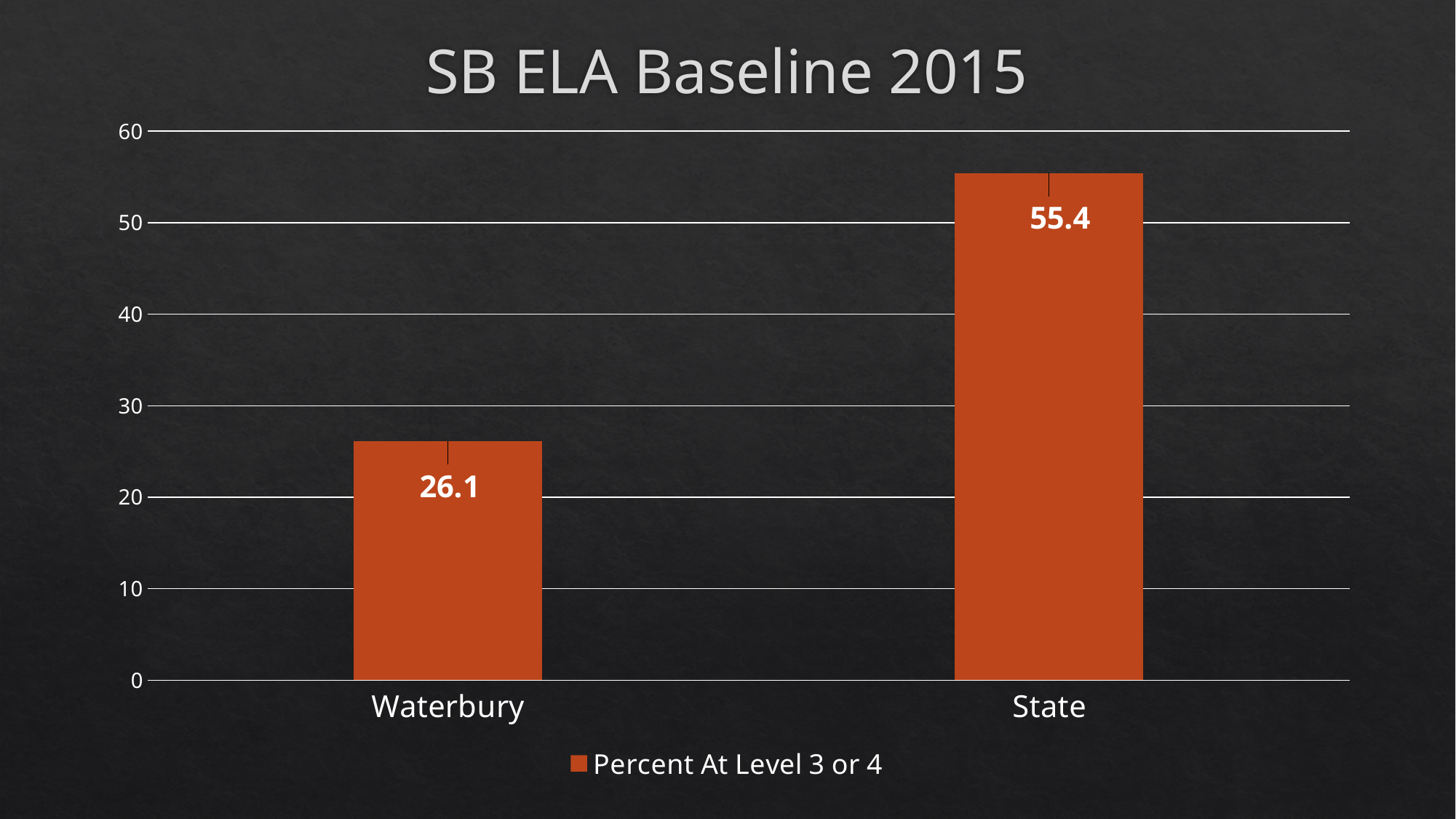
How many categories are shown on the x axis? 2 Is the value for Waterbury greater or less than 30? less Which is larger, the value for Waterbury or the value for State? State What is the value for Waterbury? 26.1 How many series does the legend list? 1 Which category has the lowest value? Waterbury What is the title of the chart? SB ELA Baseline 2015 What is the value for State? 55.4 Is the value for State greater or less than 50? greater What kind of chart is shown on the slide? bar chart What is the difference between the State value and the Waterbury value? 29.3 Which category has the highest value? State